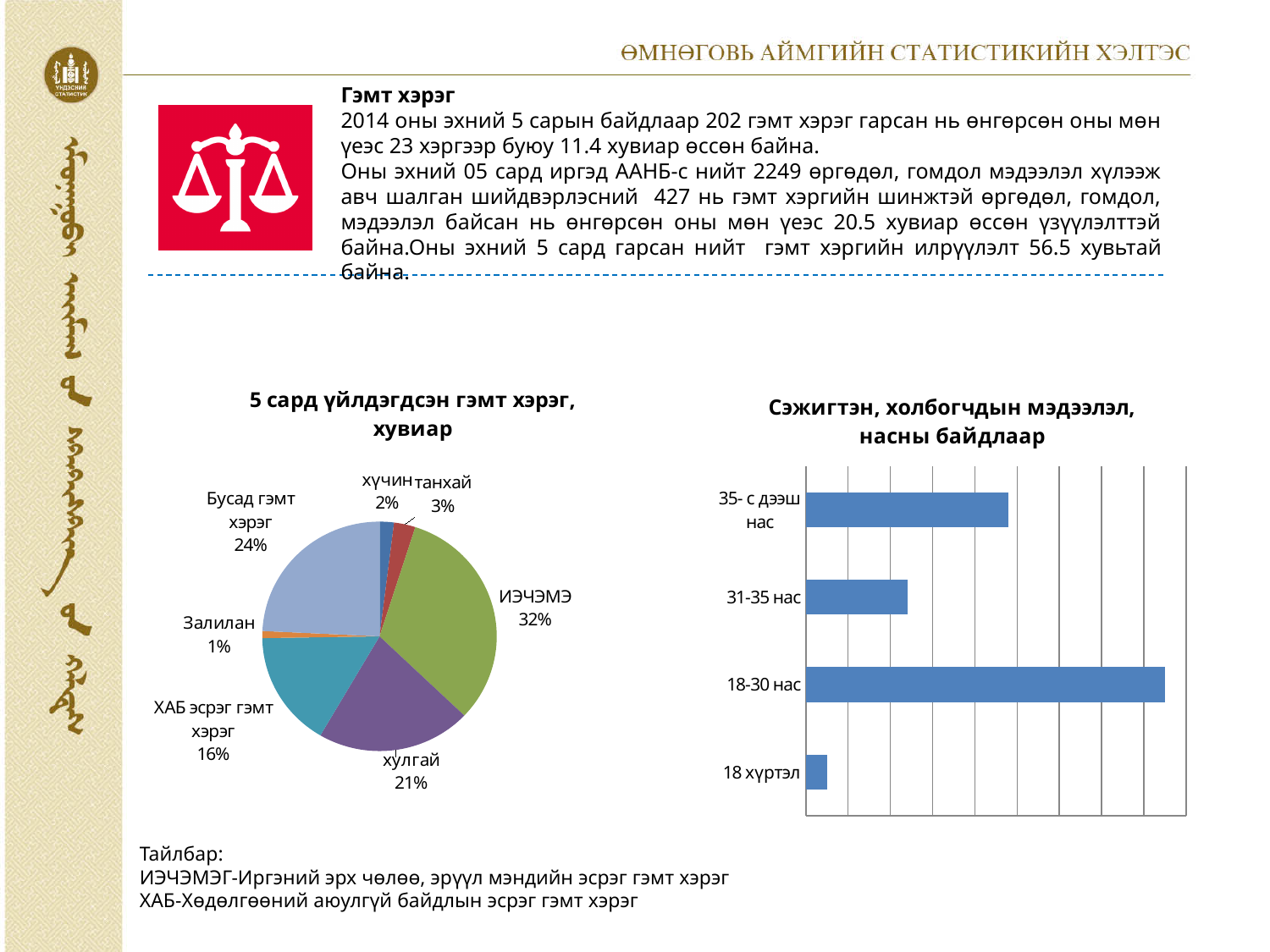
What kind of chart is the chart on the right, titled "Сэжигтэн, холбогчдын мэдээлэл, насны байдлаар"? Bar chart In the pie chart titled "5 сард үйлдэгдсэн гэмт хэрэг, хувиар", which category has the largest share? ИЭЧЭМЭ In the pie chart titled "5 сард үйлдэгдсэн гэмт хэрэг, хувиар", what share does ИЭЧЭМЭ have? 32% In the bar chart titled "Сэжигтэн, холбогчдын мэдээлэл, насны байдлаар", which age group has the lowest value? 18 хүртэл In the pie chart titled "5 сард үйлдэгдсэн гэмт хэрэг, хувиар", what is the difference between Бусад гэмт хэрэг and хулгай? 3% In the pie chart titled "5 сард үйлдэгдсэн гэмт хэрэг, хувиар", which is larger: танхай or хүчин? танхай In the pie chart titled "5 сард үйлдэгдсэн гэмт хэрэг, хувиар", what is the value for хулгай? 21% In the pie chart titled "5 сард үйлдэгдсэн гэмт хэрэг, хувиар", which category has the smallest share? Залилан In the bar chart titled "Сэжигтэн, холбогчдын мэдээлэл, насны байдлаар", which age group has the highest value? 18-30 нас In the bar chart titled "Сэжигтэн, холбогчдын мэдээлэл, насны байдлаар", which is larger: 35- с дээш нас or 31-35 нас? 35- с дээш нас In the pie chart titled "5 сард үйлдэгдсэн гэмт хэрэг, хувиар", what is the value for ХАБ эсрэг гэмт хэрэг? 16% How many slices does the pie chart titled "5 сард үйлдэгдсэн гэмт хэрэг, хувиар" have? 7